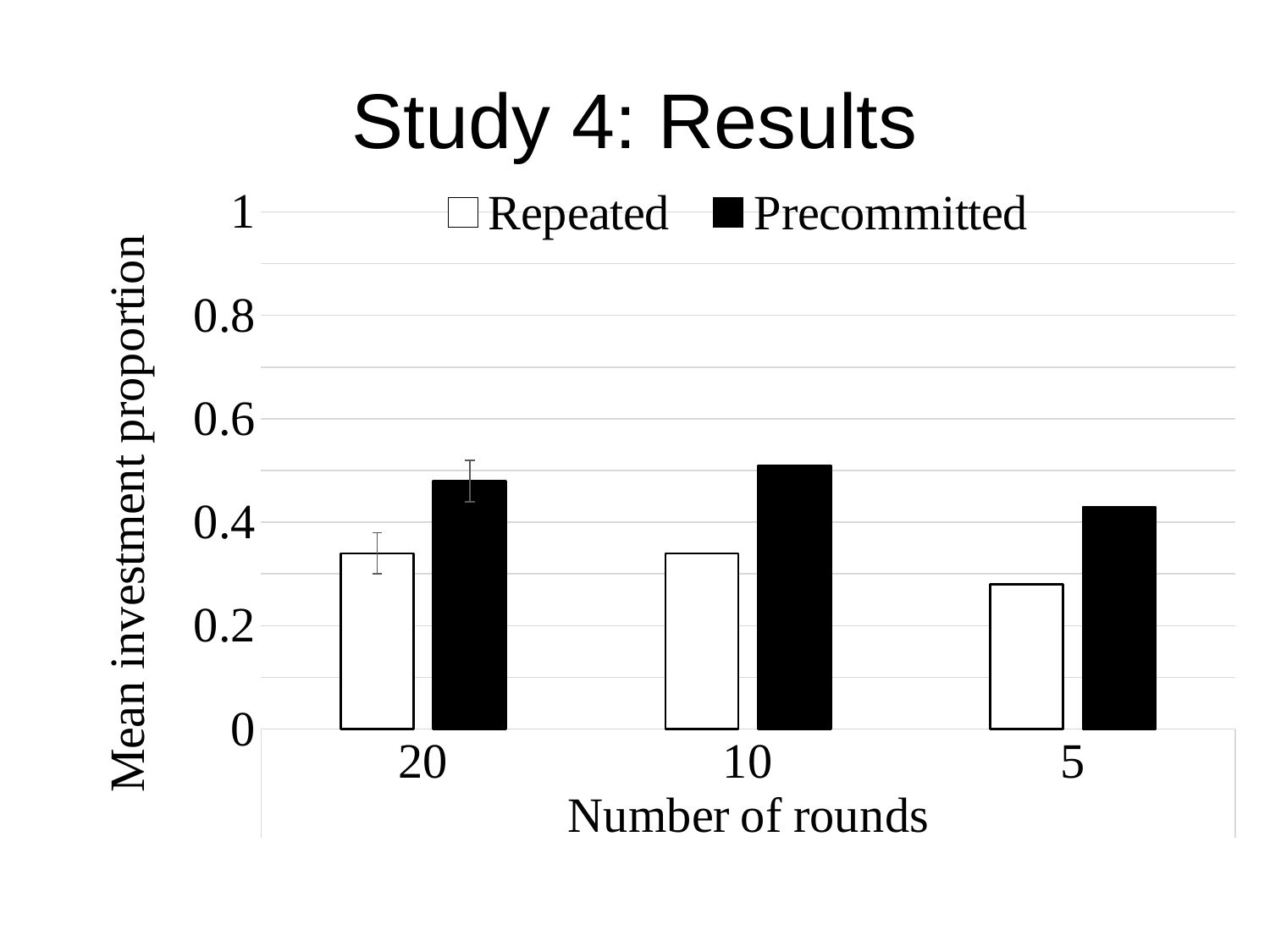
Is the value for Repeated at 5 rounds greater or less than 0.2? greater How many categories are shown on the x axis? 3 How many series does the legend list? 2 Is the value for Precommitted at 10 rounds greater or less than 0.4? greater Is the value for Precommitted at 5 rounds greater or less than 0.6? less What kind of chart is shown on the slide? bar chart Which series has the larger value at 20 rounds, Repeated or Precommitted? Precommitted Which series has the larger value at 10 rounds, Repeated or Precommitted? Precommitted Which series has the larger value at 5 rounds, Repeated or Precommitted? Precommitted For the Repeated series, which number of rounds has the lowest mean investment proportion? 5 What is the title of the y axis? Mean investment proportion